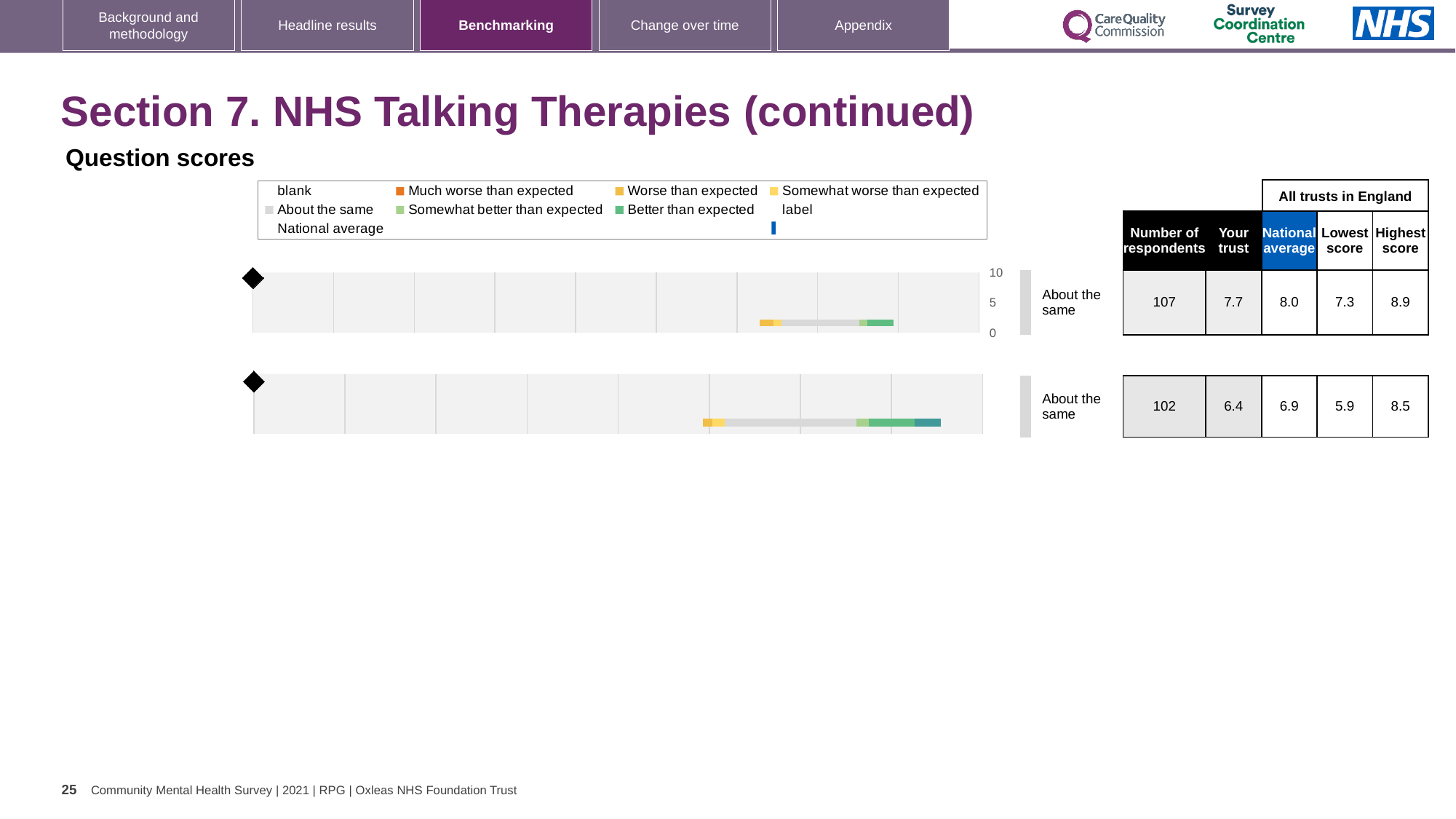
For the top chart row, what is the national average score? 8.0 For the bottom chart row, how many respondents are there? 102 For the bottom chart row, what is the 'Your trust' score? 6.4 For the bottom chart row, what is the difference between the highest score and the lowest score? 2.6 In the legend, which colour represents 'Much worse than expected'? orange What kind of chart is used to show the question scores on this slide? bar chart For the top chart row, what is the difference between the national average and the 'Your trust' score? 0.3 What benchmark category label is shown next to both chart rows? About the same For the top chart row, which is larger: the 'Your trust' score or the national average? National average How many question score rows (charts) are shown on the slide? 2 For the top chart row, what is the 'Your trust' score? 7.7